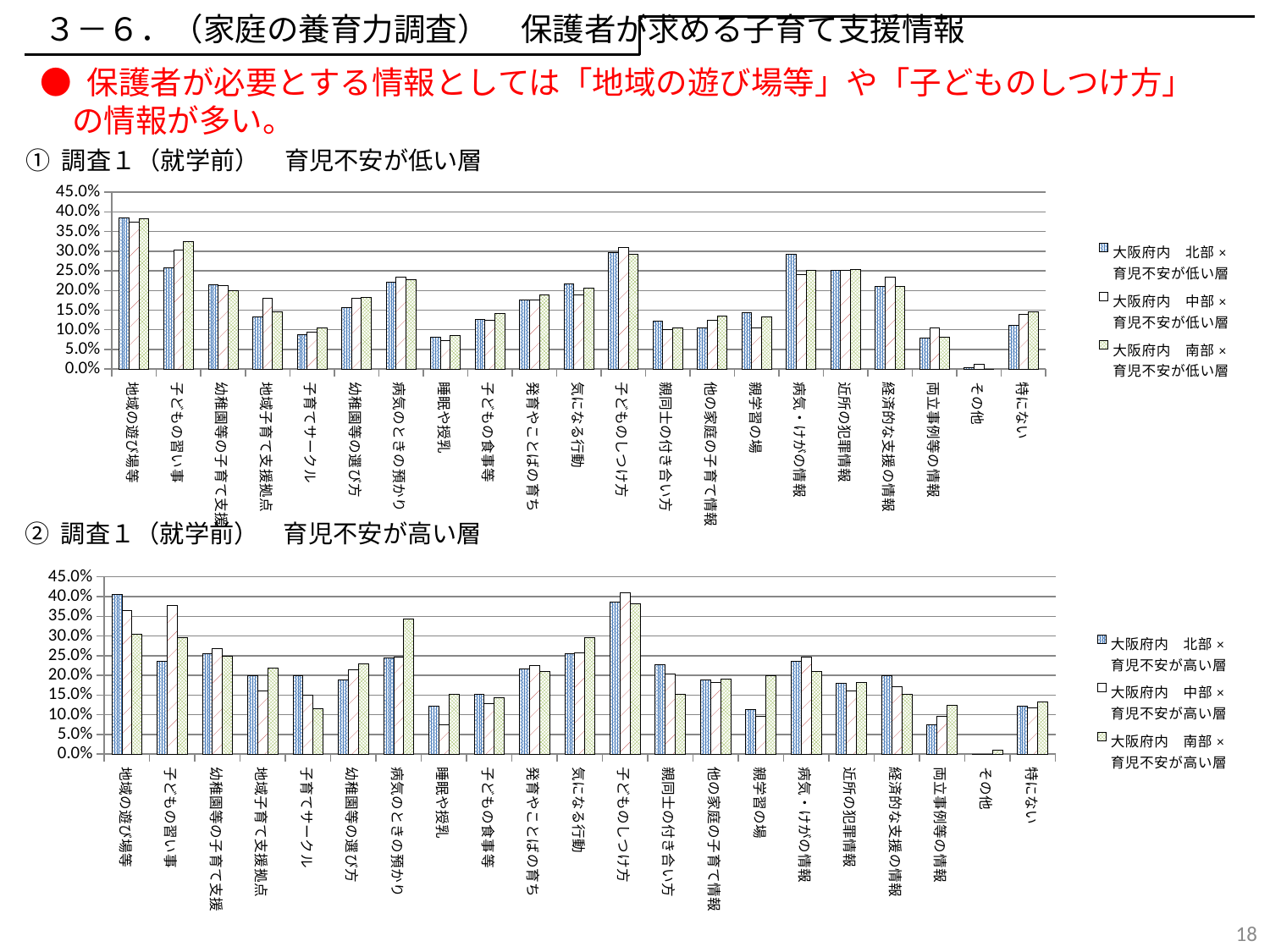
In the upper chart (育児不安が低い層), for 子どもの習い事, which series is larger: 大阪府内 北部 or 大阪府内 南部? 大阪府内 南部 In the lower chart (育児不安が高い層), for 子どもの習い事, which series is larger: 大阪府内 北部 or 大阪府内 中部? 大阪府内 中部 In the lower chart (育児不安が高い層), is the value for 親学習の場 in the 大阪府内 北部 series greater or less than 15.0%? less In the upper chart (育児不安が低い層), which category has the lowest values? その他 In the upper chart (育児不安が低い層), which category has the highest values? 地域の遊び場等 In the upper chart (育児不安が低い層), is the value for 地域の遊び場等 in the 大阪府内 北部 series greater or less than 35.0%? greater How many series does the legend of the lower chart (育児不安が高い層) list? 3 In the upper chart (育児不安が低い層), is the value for 睡眠や授乳 in the 大阪府内 北部 series greater or less than 10.0%? less How many categories are shown on the x axis of the upper chart (育児不安が低い層)? 21 In the lower chart (育児不安が高い層), which category has the lowest values? その他 What kind of chart is the upper chart (調査1（就学前） 育児不安が低い層)? bar chart